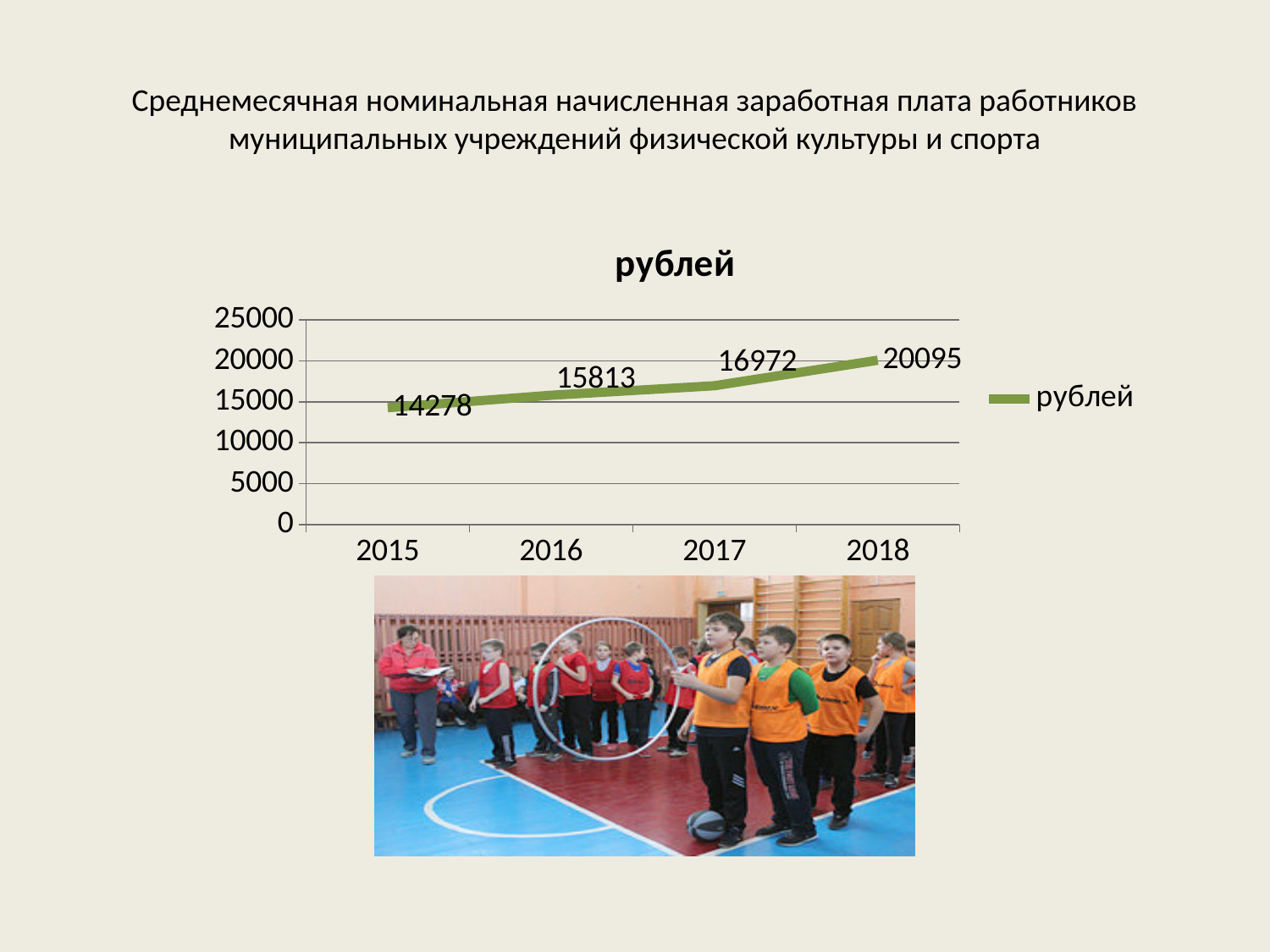
What is the value for 2017? 16972 What kind of chart is shown on the slide? line chart What is the difference between the values for 2017 and 2016? 1159 Which is larger, the value for 2016 or the value for 2017? 2017 What is the value for 2018? 20095 Which year has the highest value? 2018 How many years are plotted on the chart? 4 Is the value for 2018 greater or less than 20000? greater Which year has the lowest value? 2015 What is the difference between the values for 2018 and 2015? 5817 What is the value for 2016? 15813 What is the value for 2015? 14278